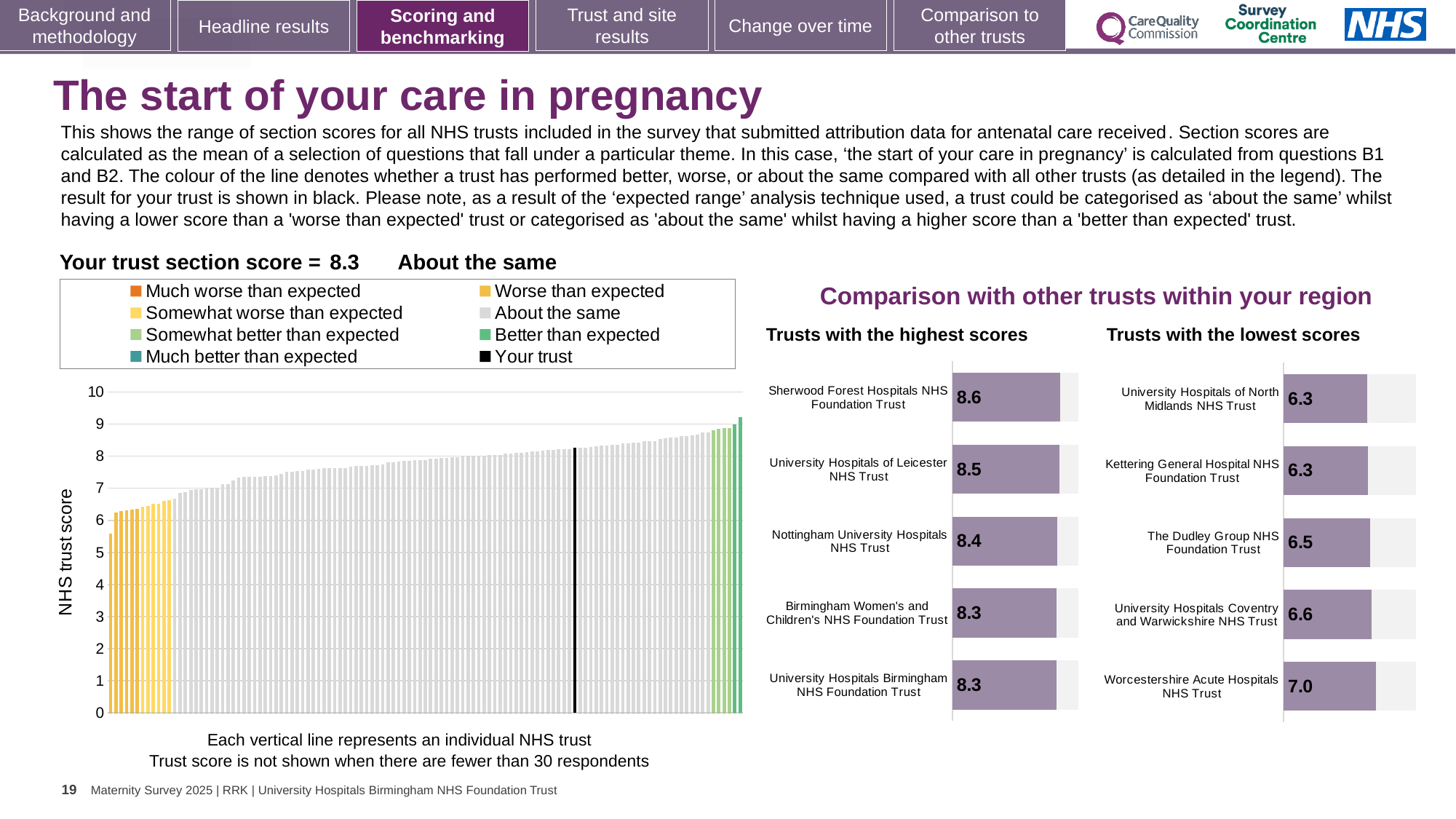
How many trusts are shown in the 'Trusts with the highest scores' chart? 5 In the 'Trusts with the lowest scores' chart, which has the larger score: University Hospitals Coventry and Warwickshire NHS Trust or The Dudley Group NHS Foundation Trust? University Hospitals Coventry and Warwickshire NHS Trust In the large 'NHS trust score' chart on the left, do the values rise or fall from left to right? rise In the 'Trusts with the highest scores' chart, what is the score for Sherwood Forest Hospitals NHS Foundation Trust? 8.6 In the 'Trusts with the highest scores' chart, what is the difference between the scores of Sherwood Forest Hospitals NHS Foundation Trust and Nottingham University Hospitals NHS Trust? 0.2 In the 'Trusts with the highest scores' chart, which trust has the highest score? Sherwood Forest Hospitals NHS Foundation Trust In the 'Trusts with the lowest scores' chart, what is the score for The Dudley Group NHS Foundation Trust? 6.5 In the 'Trusts with the lowest scores' chart, what is the difference between the scores of Worcestershire Acute Hospitals NHS Trust and The Dudley Group NHS Foundation Trust? 0.5 In the 'Trusts with the lowest scores' chart, what is the score for Worcestershire Acute Hospitals NHS Trust? 7.0 In the 'Trusts with the lowest scores' chart, which trust has the highest score? Worcestershire Acute Hospitals NHS Trust What kind of chart is the large 'NHS trust score' chart on the left? bar chart In the 'Trusts with the highest scores' chart, what is the score for Nottingham University Hospitals NHS Trust? 8.4